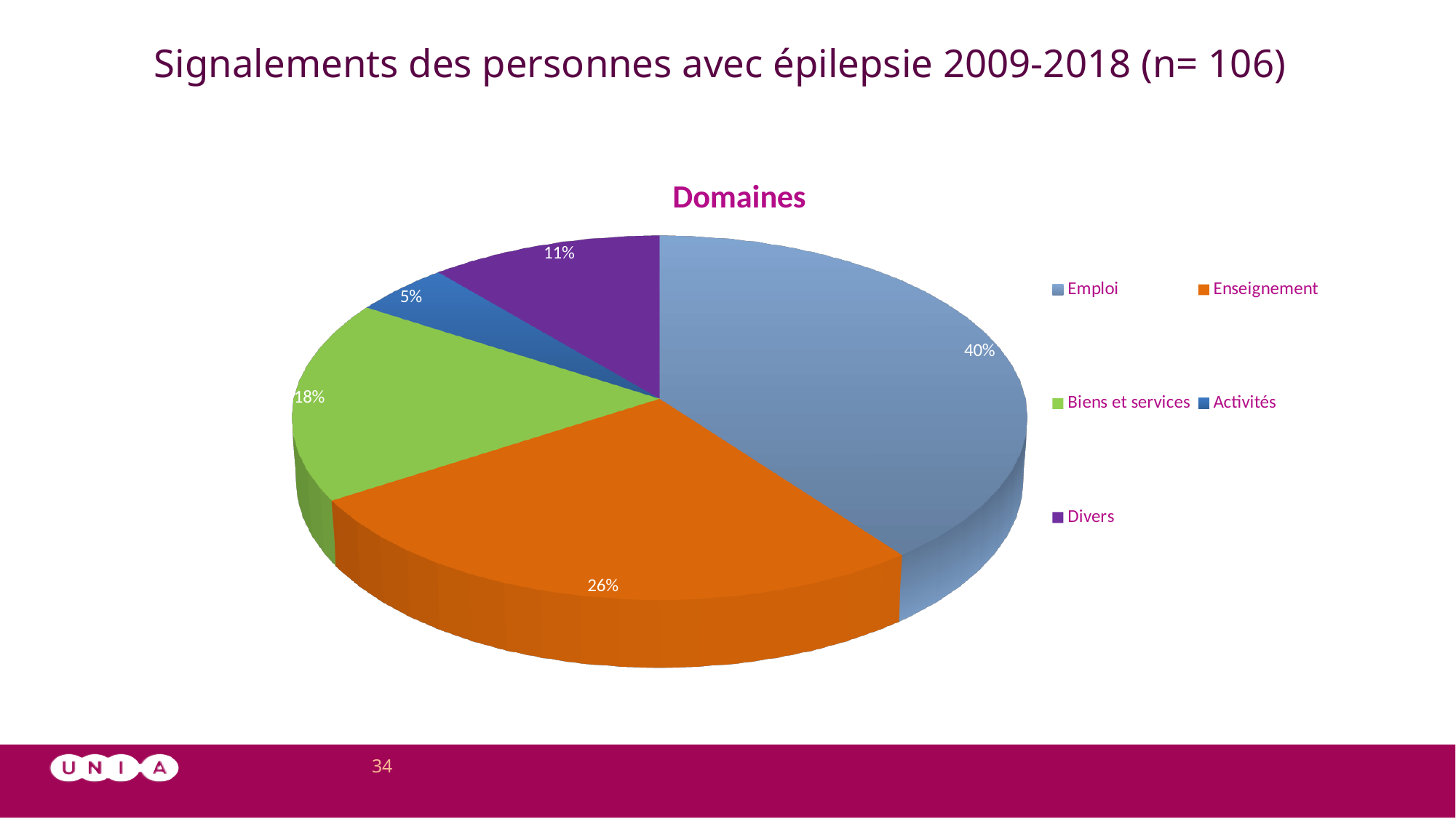
What kind of chart is shown on the slide? Pie chart What share of the pie does Activités represent? 5% What share of the pie does Biens et services represent? 18% What is the difference in percentage points between Emploi and Enseignement? 14 Which category has the smallest slice of the pie? Activités How many categories are shown in the pie chart? 5 Which is larger, the share for Biens et services or the share for Divers? Biens et services Which category has the largest slice of the pie? Emploi What share of the pie does Enseignement represent? 26% What is the title of the chart? Domaines